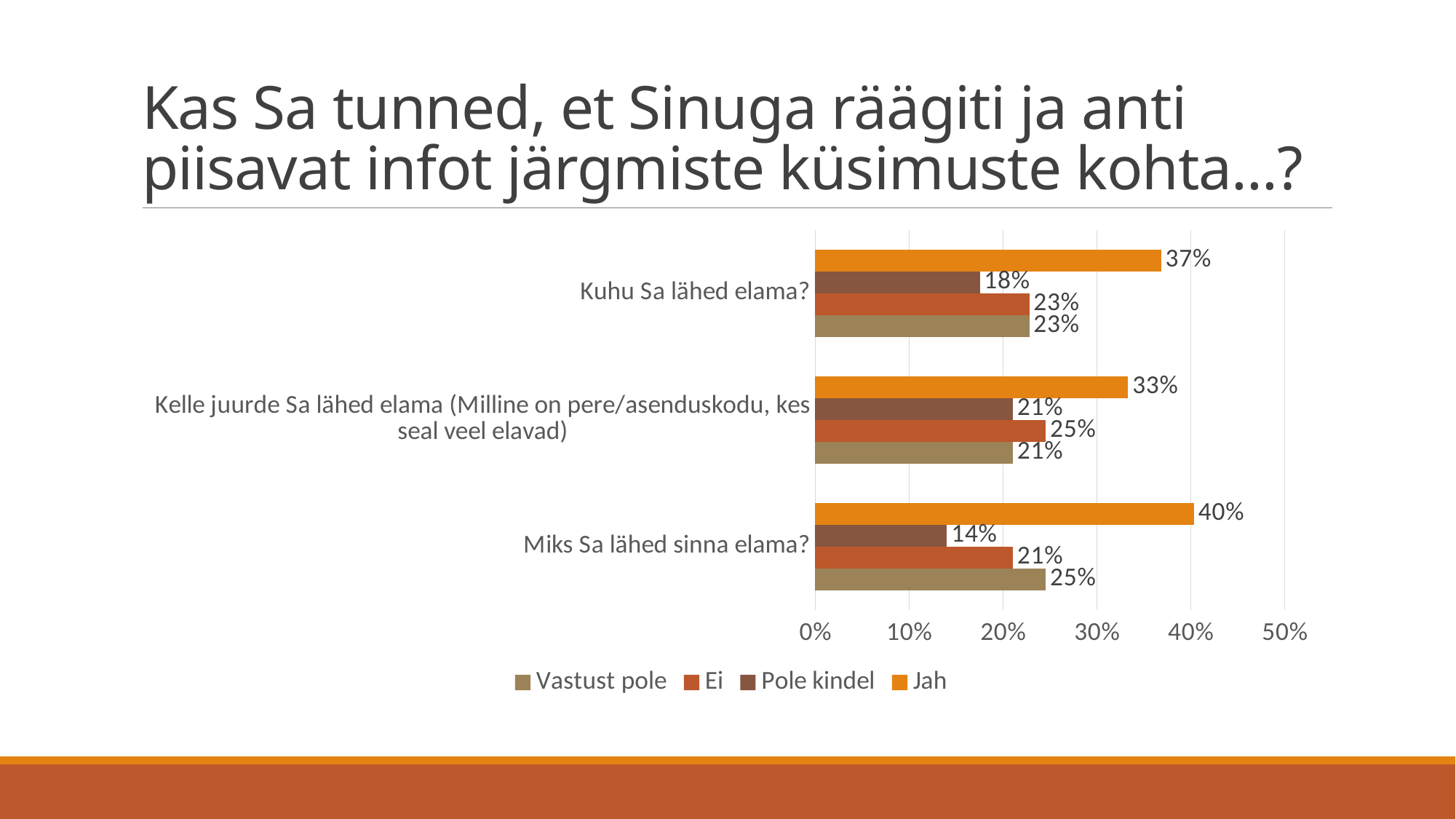
How many series does the legend list? 4 How many questions (categories) are shown on the chart? 3 What is the value of "Pole kindel" for "Kuhu Sa lähed elama?"? 18% What is the difference between the "Jah" values for "Miks Sa lähed sinna elama?" and "Kelle juurde Sa lähed elama (Milline on pere/asenduskodu, kes seal veel elavad)"? 7% Which legend entry is shown in the lightest (tan) colour? Vastust pole What is the value of "Jah" for "Miks Sa lähed sinna elama?"? 40% What is the value of "Vastust pole" for "Miks Sa lähed sinna elama?"? 25% What is the value of "Ei" for "Kelle juurde Sa lähed elama (Milline on pere/asenduskodu, kes seal veel elavad)"? 25% What kind of chart is shown on the slide? Bar chart For which question is the "Pole kindel" value lowest? Miks Sa lähed sinna elama? Which is larger for "Kuhu Sa lähed elama?": the "Jah" value or the "Ei" value? Jah For which question is the "Jah" value highest? Miks Sa lähed sinna elama?